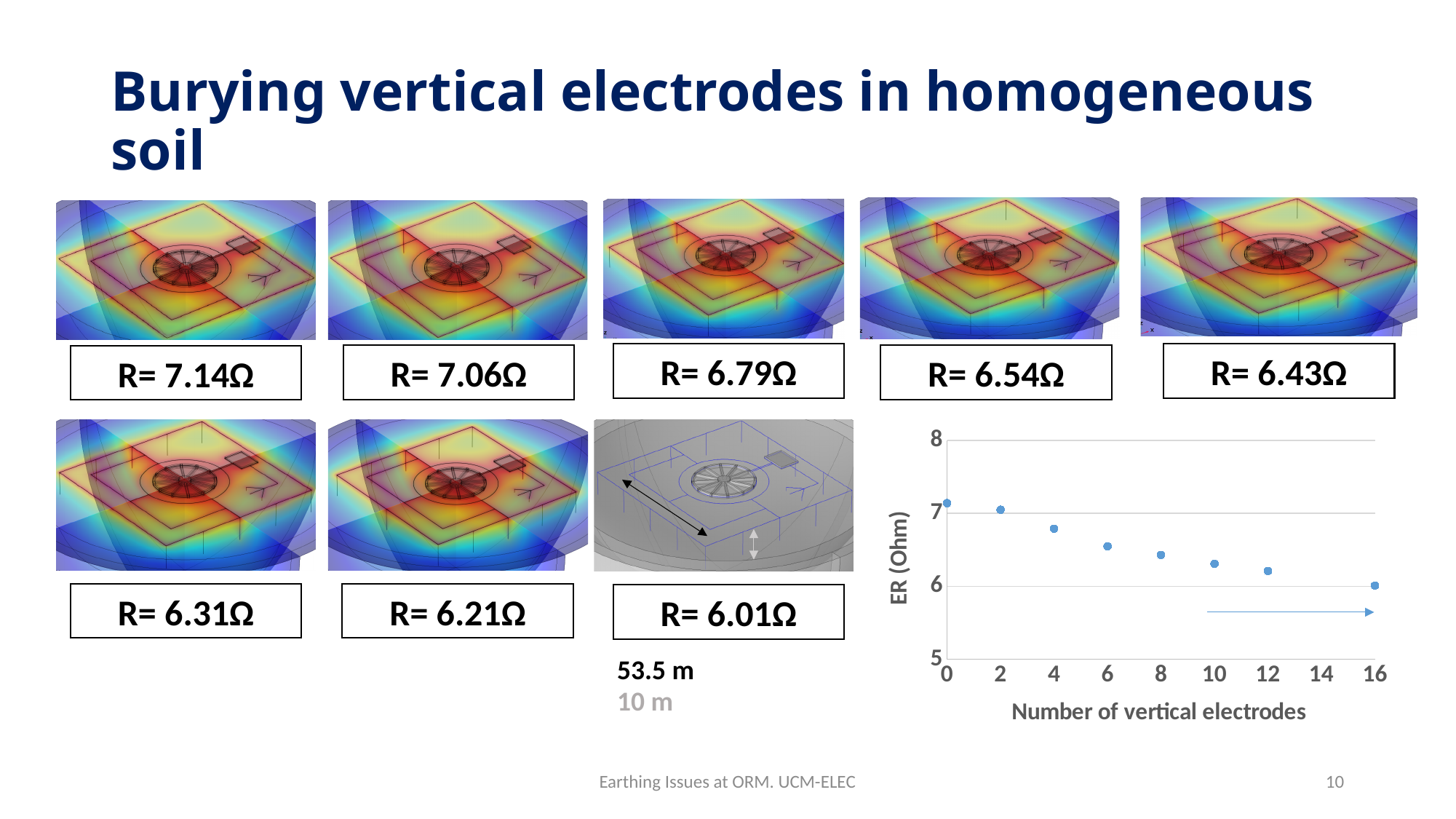
At which number of vertical electrodes is ER lowest? 16 What is the title of the x axis of the chart? Number of vertical electrodes At which number of vertical electrodes is ER highest? 0 Does ER rise or fall as the number of vertical electrodes increases? fall Is the ER value for 12 vertical electrodes greater or less than 6? greater Is the ER value for 4 vertical electrodes greater or less than 7? less What kind of chart is shown on the slide? scatter chart Which has a larger ER value: 6 vertical electrodes or 16 vertical electrodes? 6 vertical electrodes Is the ER value for 8 vertical electrodes greater or less than 7? less What is the title of the y axis of the chart? ER (Ohm) Which has a larger ER value: 2 vertical electrodes or 10 vertical electrodes? 2 vertical electrodes How many data points are plotted in the chart? 8